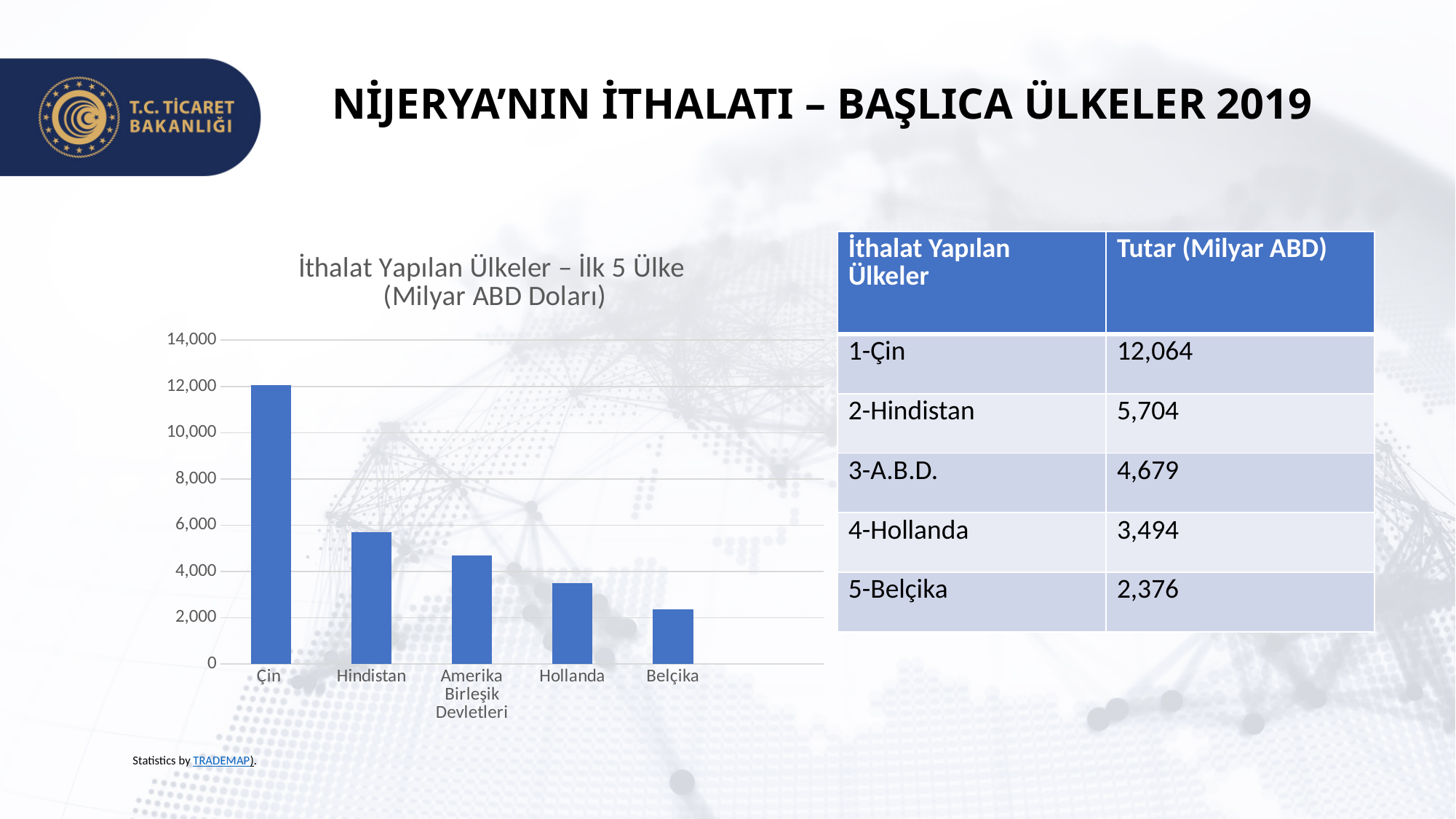
What is the title of the bar chart? İthalat Yapılan Ülkeler – İlk 5 Ülke (Milyar ABD Doları) Is the value for Hindistan greater or less than 6,000? less Is the value for Çin greater or less than 10,000? greater Do the bar values rise or fall from left to right across the x axis? fall Which country has the lowest bar in the chart? Belçika What kind of chart is shown on the slide? bar chart Which country has the highest bar in the chart? Çin How many countries are plotted in the bar chart? 5 According to the table on the slide, what is the import amount for Çin in billion USD? 12,064 According to the table on the slide, what is the import amount for Belçika in billion USD? 2,376 Is the value for Hollanda greater or less than 4,000? less Which is larger, the bar for Hindistan or the bar for Amerika Birleşik Devletleri? Hindistan